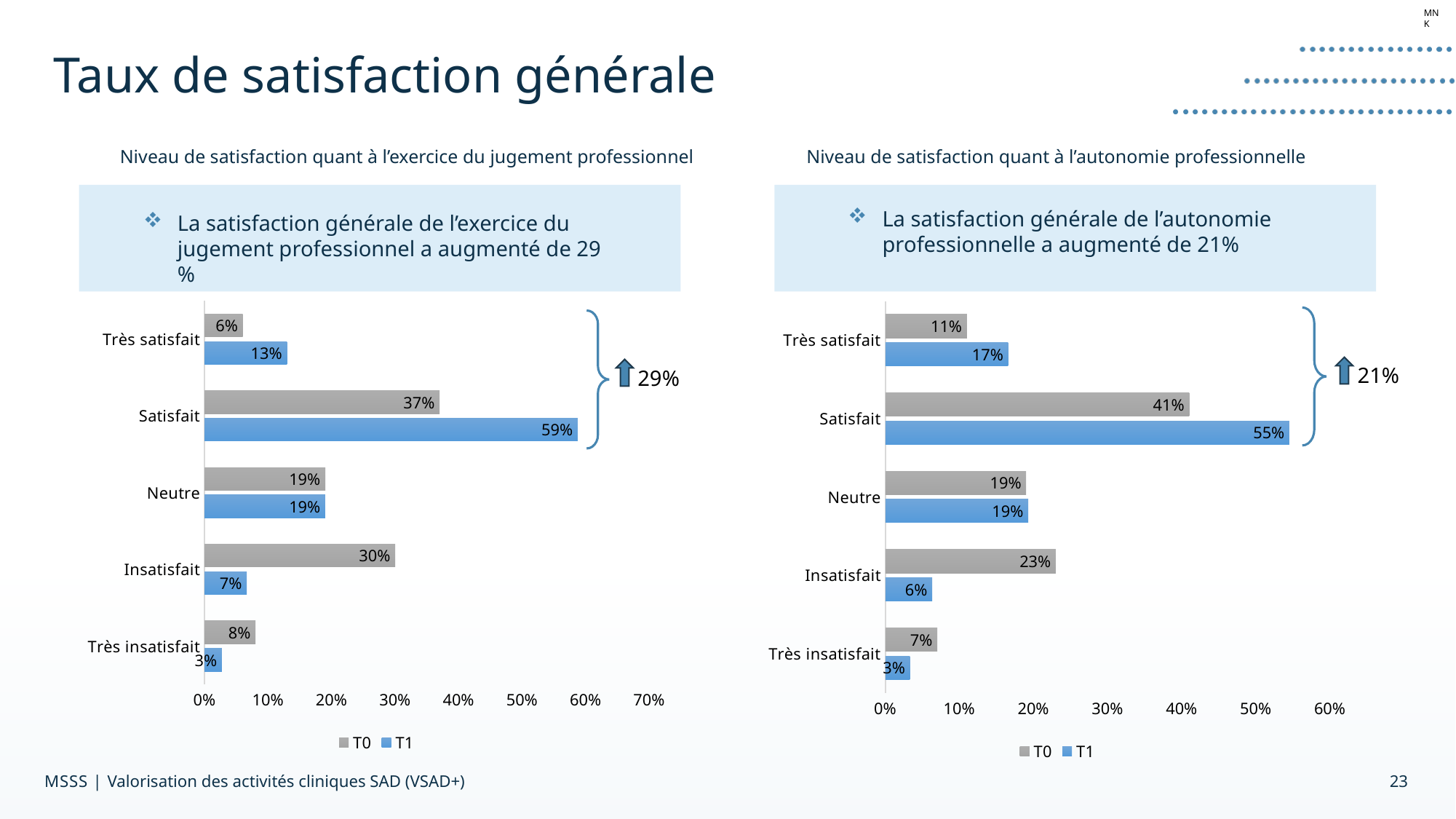
In the left chart (jugement professionnel), what is the T0 value for Insatisfait? 30% In the right chart (autonomie professionnelle), which category has the lowest T1 value? Très insatisfait In the right chart (autonomie professionnelle), what is the T0 value for Satisfait? 41% What type of chart is the right chart (autonomie professionnelle)? Bar chart In the left chart (jugement professionnel), which is larger for Très satisfait: T0 or T1? T1 In the right chart (autonomie professionnelle), what is the difference between the T0 and T1 values for Insatisfait? 17% In the left chart (jugement professionnel), what is the difference between the T1 and T0 values for Satisfait? 22% In the left chart (jugement professionnel), what is the T1 value for Satisfait? 59% In the right chart (autonomie professionnelle), what is the T1 value for Très satisfait? 17% How many series does the legend of the left chart (jugement professionnel) list? 2 In the left chart (jugement professionnel), which category has the highest T1 value? Satisfait How many categories are shown in the right chart (autonomie professionnelle)? 5